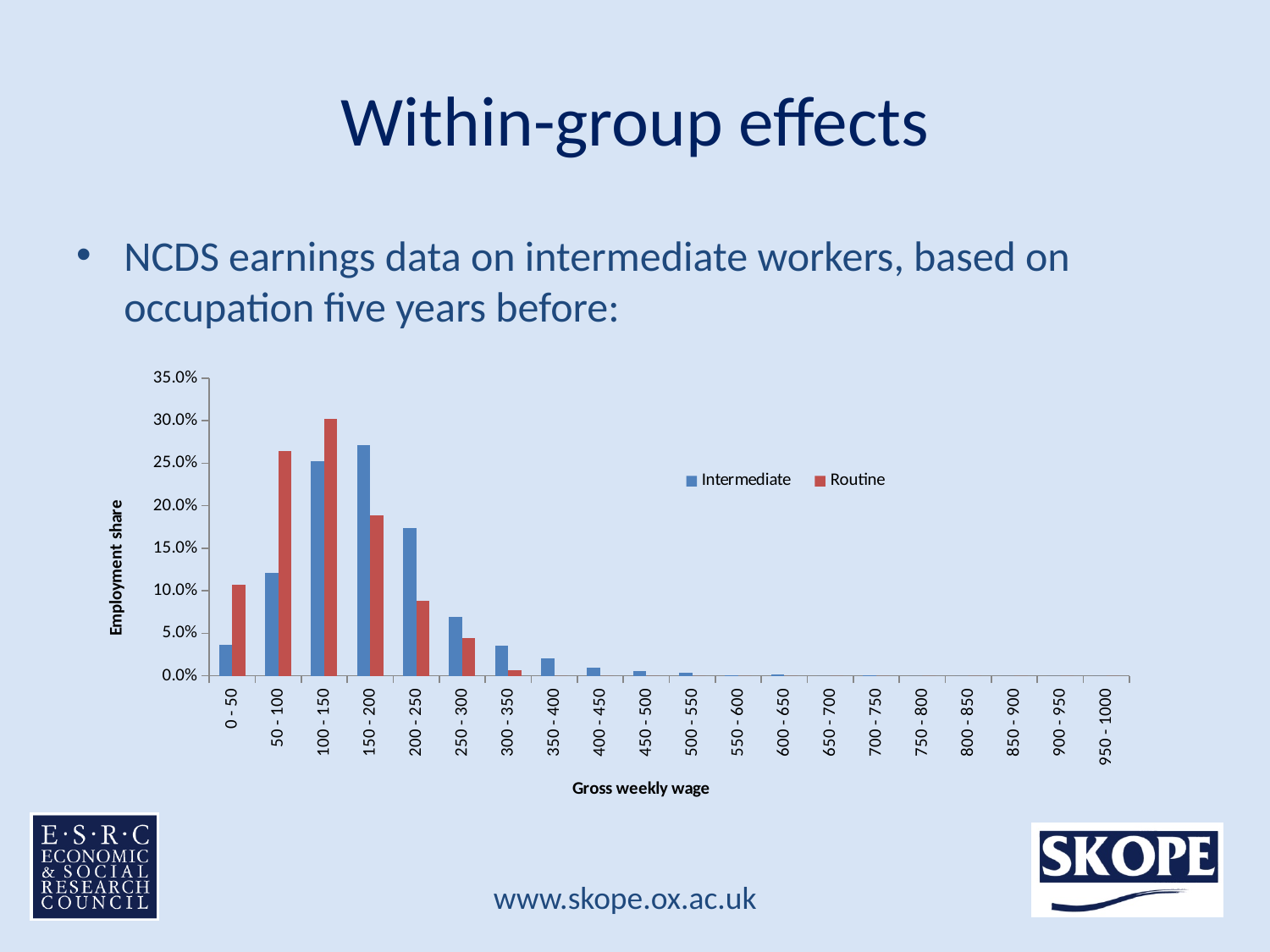
What kind of chart is shown on the slide? Bar chart Which wage band has the highest employment share for the Routine series? 100 - 150 In the 0 - 50 wage band, which series has the larger employment share, Intermediate or Routine? Routine From the 150 - 200 wage band onward, do the Intermediate employment shares rise or fall as the wage increases? Fall How many wage bands are shown on the x axis? 20 Is the Routine employment share for the 200 - 250 wage band greater or less than 10.0%? less Is the Intermediate employment share for the 200 - 250 wage band greater or less than 15.0%? greater What is the title of the vertical axis of the chart? Employment share In the 150 - 200 wage band, which series has the larger employment share, Intermediate or Routine? Intermediate How many series does the legend list? 2 Which wage band has the highest employment share for the Intermediate series? 150 - 200 Is the Routine employment share for the 100 - 150 wage band greater or less than 25.0%? greater